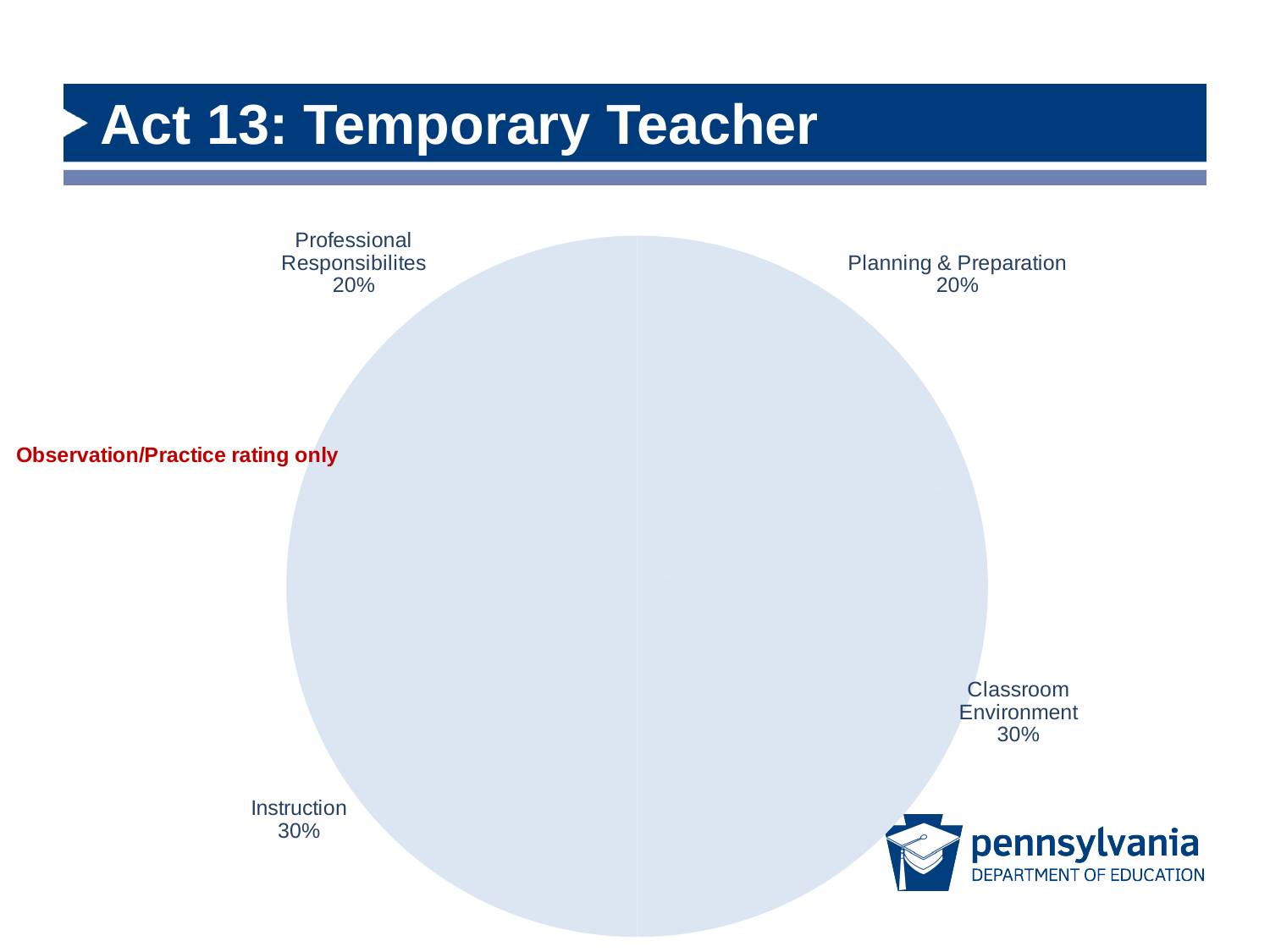
How many slices does the pie chart have? 4 What is the title of the slide containing the pie chart? Act 13: Temporary Teacher What kind of chart is shown on the slide? pie chart What do the Instruction and Classroom Environment shares add up to? 60% What share of the pie does Instruction represent? 30% What is the difference between the Classroom Environment share and the Planning & Preparation share? 10% What share of the pie does Planning & Preparation represent? 20% What is the value shown for Professional Responsibilites? 20% Which is larger, Instruction or Planning & Preparation? Instruction Which is larger, Professional Responsibilites or Classroom Environment? Classroom Environment What does the red text to the left of the pie chart say? Observation/Practice rating only What is the value shown for Classroom Environment? 30%